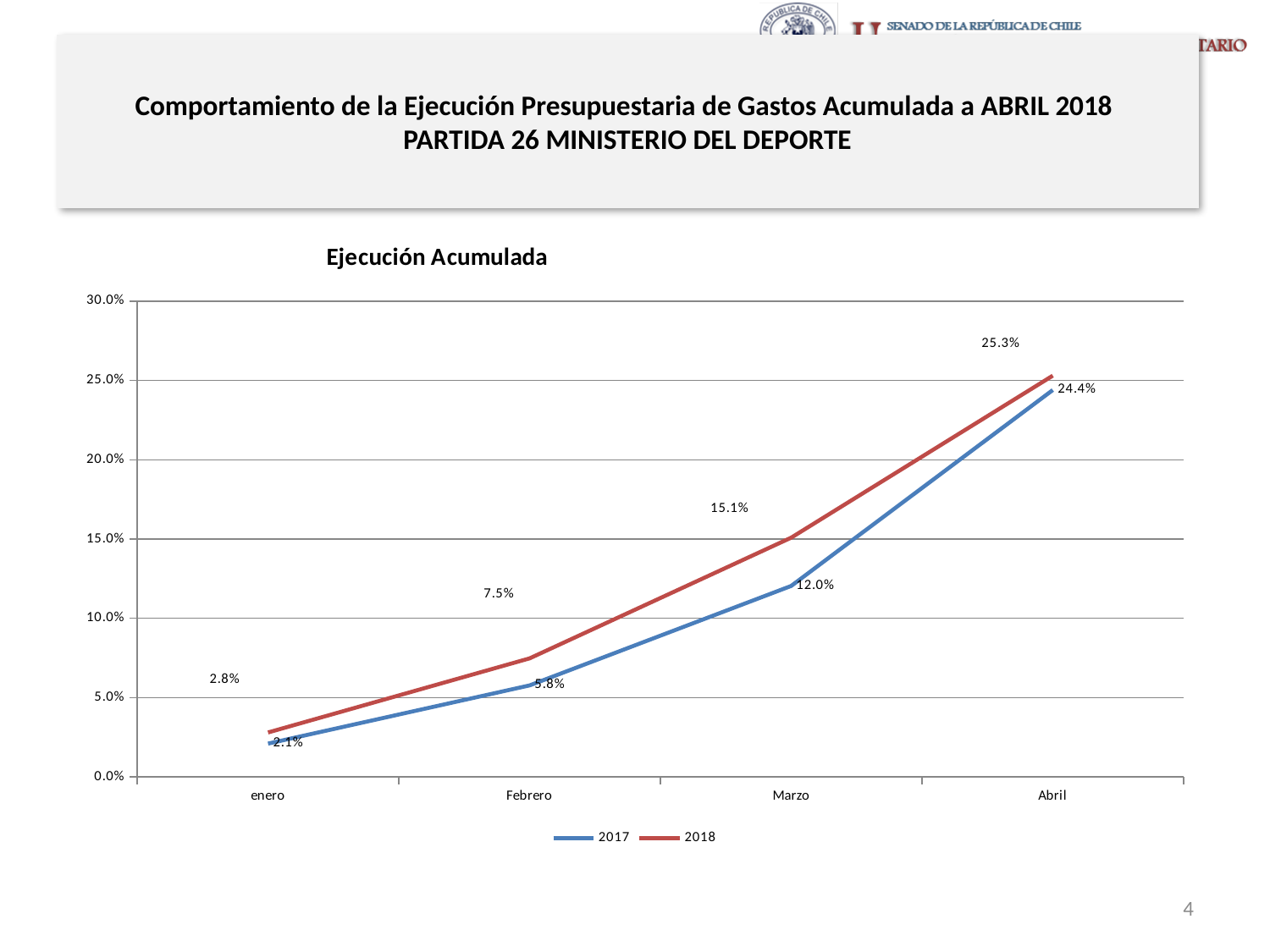
What is the value for 2017 in enero? 2.1% What is the value for 2017 in Marzo? 12.0% How many series does the legend list? 2 What is the value for 2018 in Abril? 25.3% Do the values for 2018 rise or fall from enero to Abril? rise What type of chart is shown on the slide? line chart In which month is the 2017 series at its highest? Abril How many months are shown on the x axis? 4 What is the difference between the 2018 and 2017 values in Marzo? 3.1% Which series has the larger value in Febrero, 2017 or 2018? 2018 What is the value for 2018 in Febrero? 7.5% In which month is the 2018 series at its lowest? enero